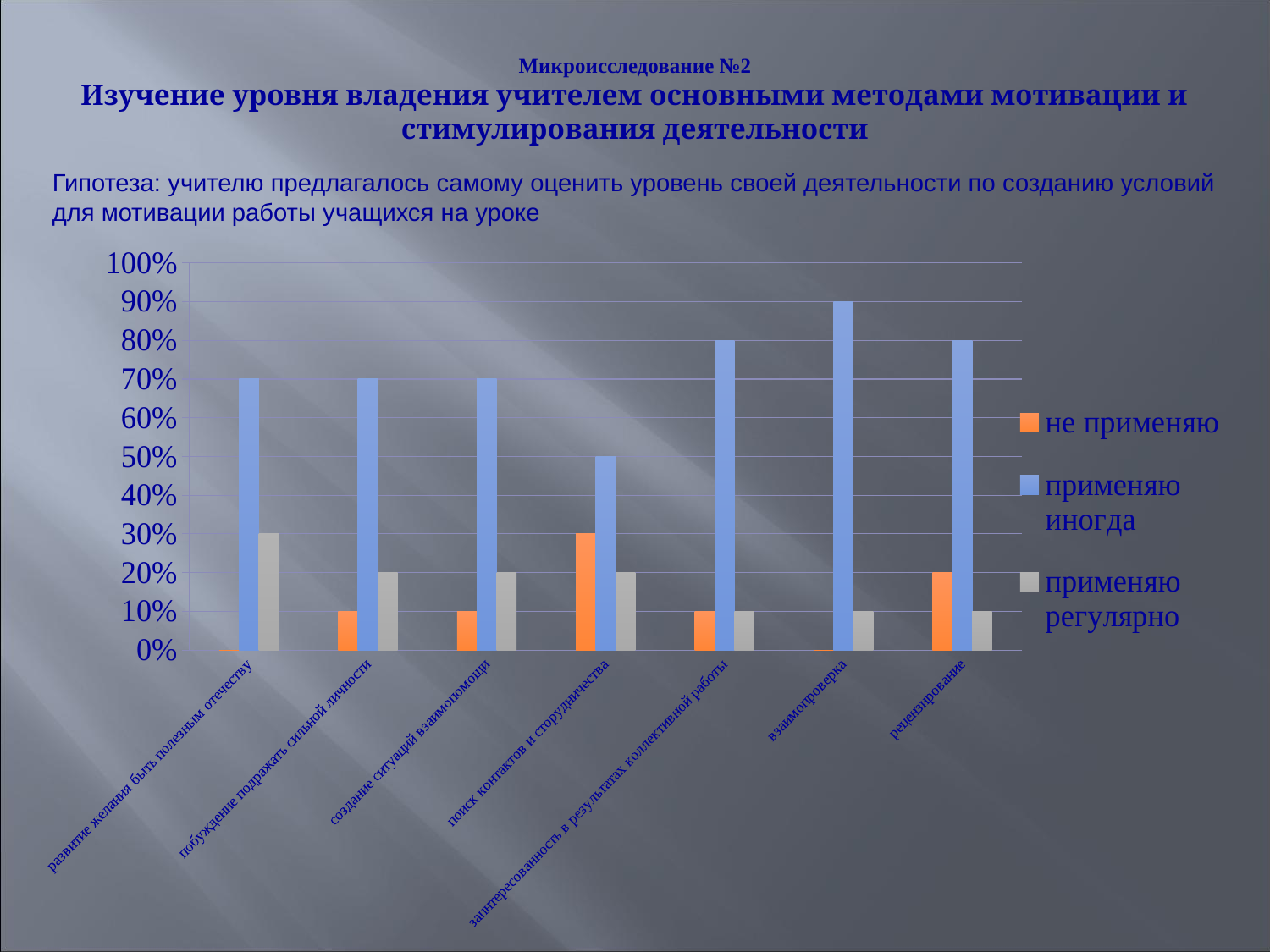
How many categories are shown on the x axis? 7 What kind of chart is shown on the slide? bar chart Which category has the lowest value for "применяю иногда"? поиск контактов и сотрудничества Which is larger for "поиск контактов и сотрудничества": "не применяю" or "применяю регулярно"? не применяю Which category has the highest value for "применяю иногда"? взаимопроверка Is the value of "применяю иногда" for "заинтересованность в результатах коллективной работы" greater or less than 50%? greater How many series does the legend list? 3 What is the value of "не применяю" for "поиск контактов и сотрудничества"? 30% What is the value of "применяю регулярно" for "развитие желания быть полезным отечеству"? 30% What is the difference between "применяю иногда" and "применяю регулярно" for "рецензирование"? 70% Which colour represents the series "не применяю" in the legend? orange What is the value of "применяю иногда" for "взаимопроверка"? 90%